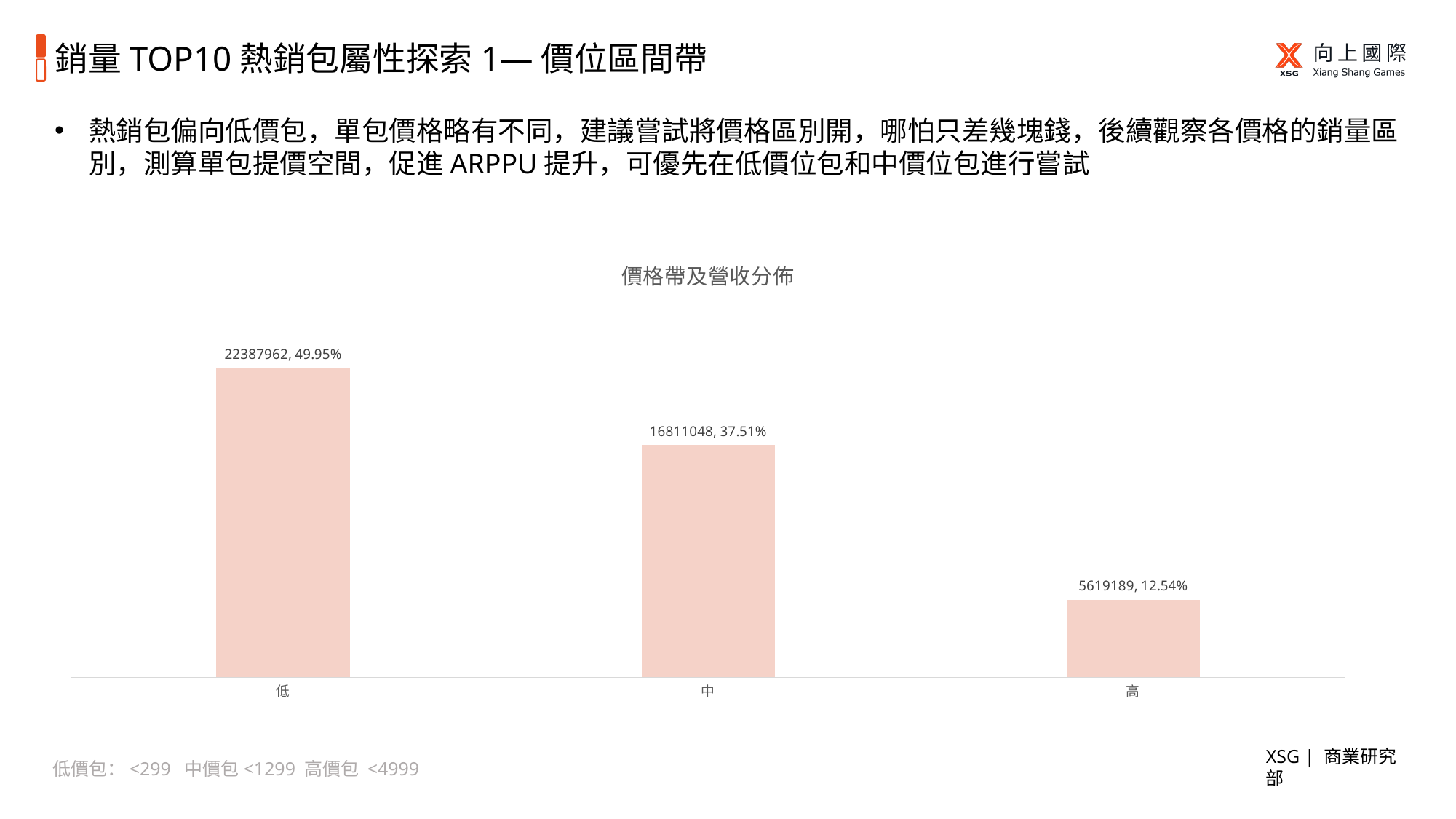
Which price band has the lowest revenue? 高 Which price band has the highest revenue? 低 What is the difference in percentage share between the 低 and 中 bars? 12.44% What is the difference in revenue between the 低 and 中 categories? 5576914 What is the title of the chart? 價格帶及營收分佈 What percentage share is labelled on the 中 bar? 37.51% What is the revenue value shown for the 高 category? 5619189 What is the revenue value shown for the 低 category? 22387962 What type of chart is shown on the slide? Bar chart How many price band categories are shown on the x axis? 3 Which has a larger revenue, 中 or 高? 中 What percentage share is labelled on the 低 bar? 49.95%